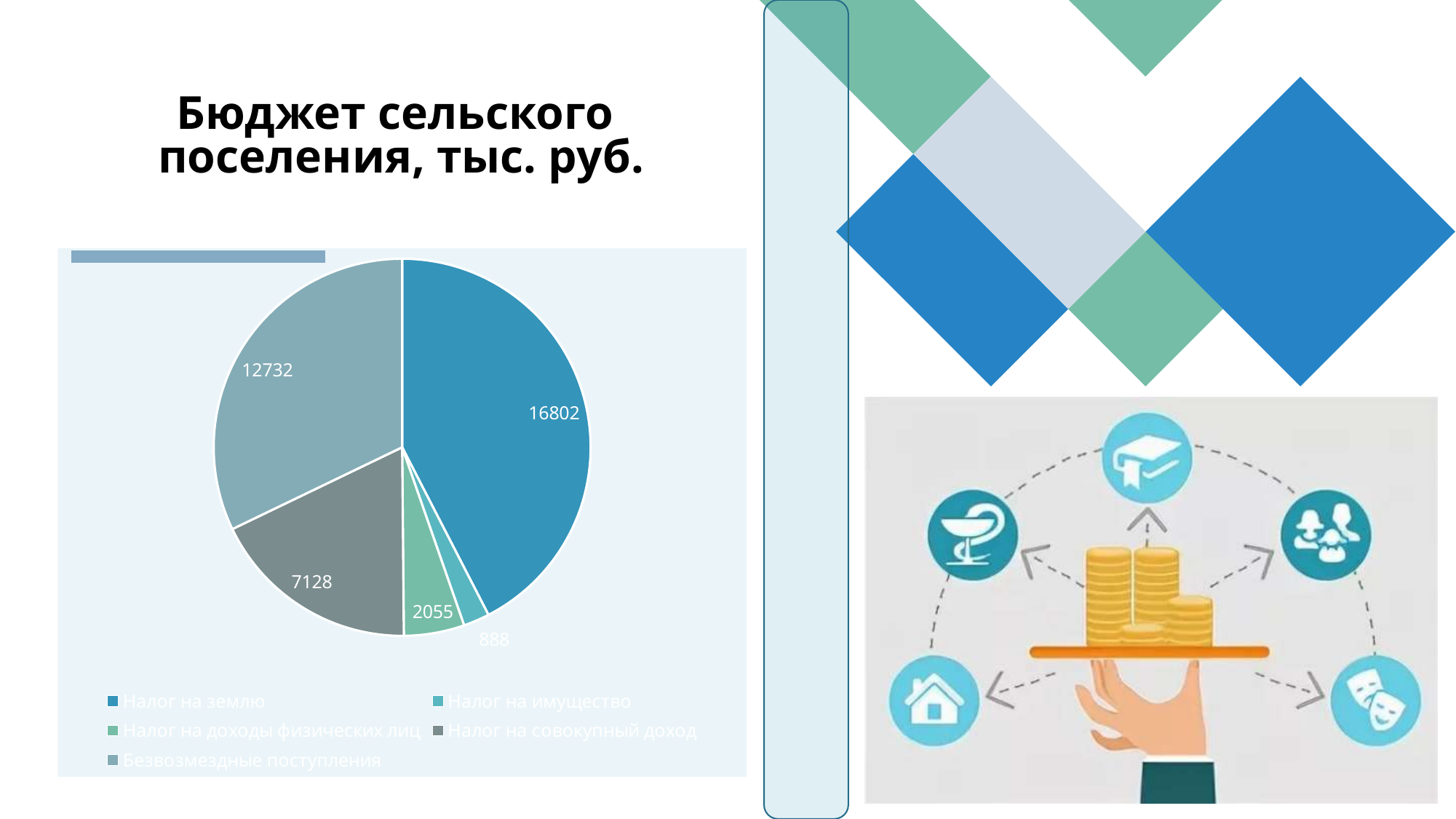
What is the value for Налог на совокупный доход? 7128 What is the value for Налог на имущество? 888 What is the title of the chart on the slide? Бюджет сельского поселения, тыс. руб. Which is larger: Безвозмездные поступления or Налог на совокупный доход? Безвозмездные поступления What is the value for Безвозмездные поступления? 12732 What is the difference between the values for Налог на совокупный доход and Налог на доходы физических лиц? 5073 What kind of chart is shown on the slide? pie chart Which category has the smallest slice of the pie? Налог на имущество What is the difference between the values for Налог на землю and Безвозмездные поступления? 4070 How many categories does the pie chart have? 5 Which category has the largest slice of the pie? Налог на землю What is the value for Налог на землю? 16802